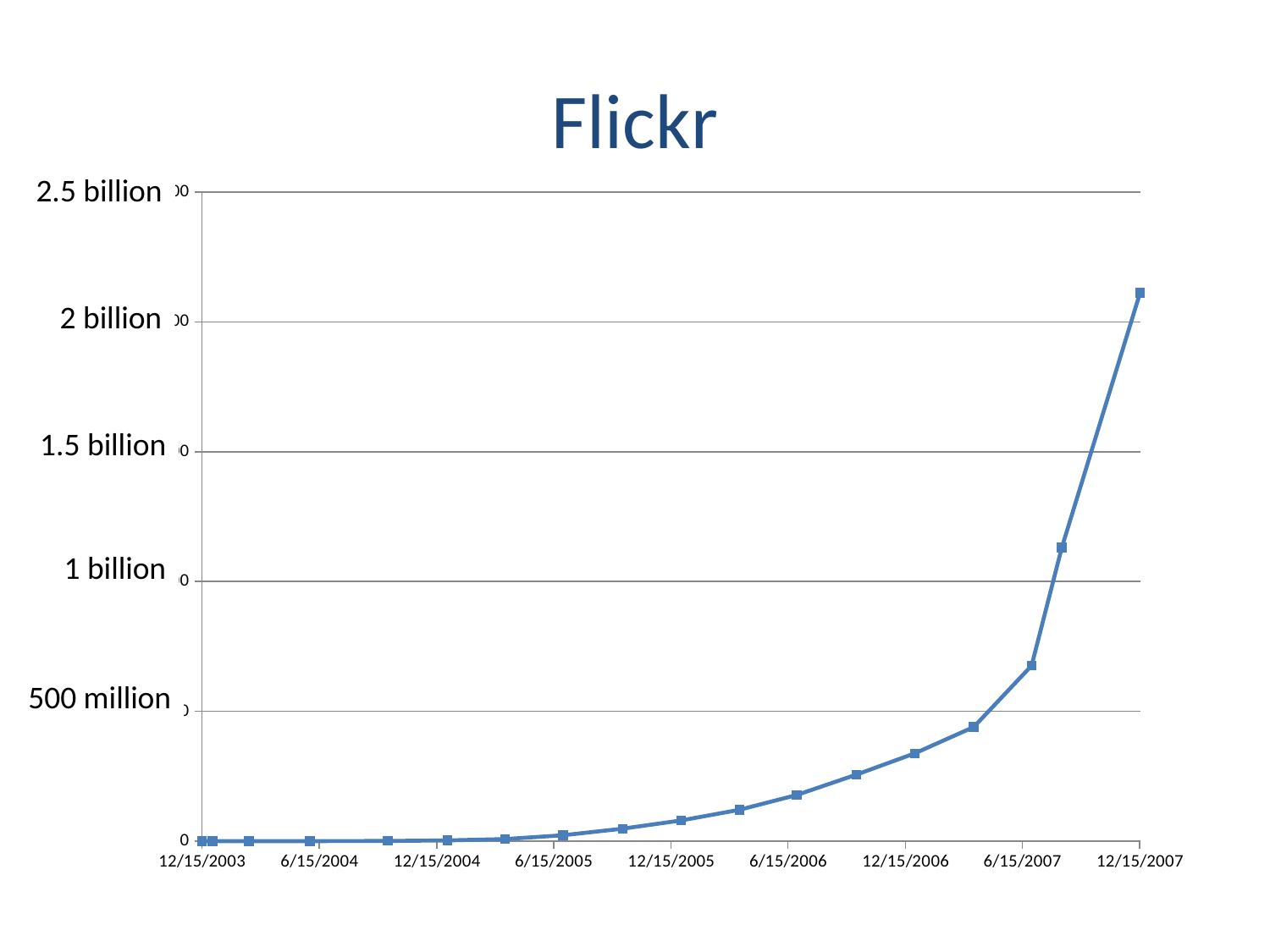
Is the value at 6/15/2007 greater or less than 500 million? greater Which date on the x axis has the highest value? 12/15/2007 What is the title of the chart? Flickr What kind of chart is shown on the slide? line chart Is the value at 12/15/2007 greater or less than 2.5 billion? less Is the value at 6/15/2006 greater or less than 500 million? less Do the values rise or fall over time along the x axis? rise Which is larger, the value at 6/15/2007 or the value at 6/15/2005? 6/15/2007 What is the highest value labelled on the y axis? 2.5 billion Which is larger, the value at 12/15/2007 or the value at 12/15/2006? 12/15/2007